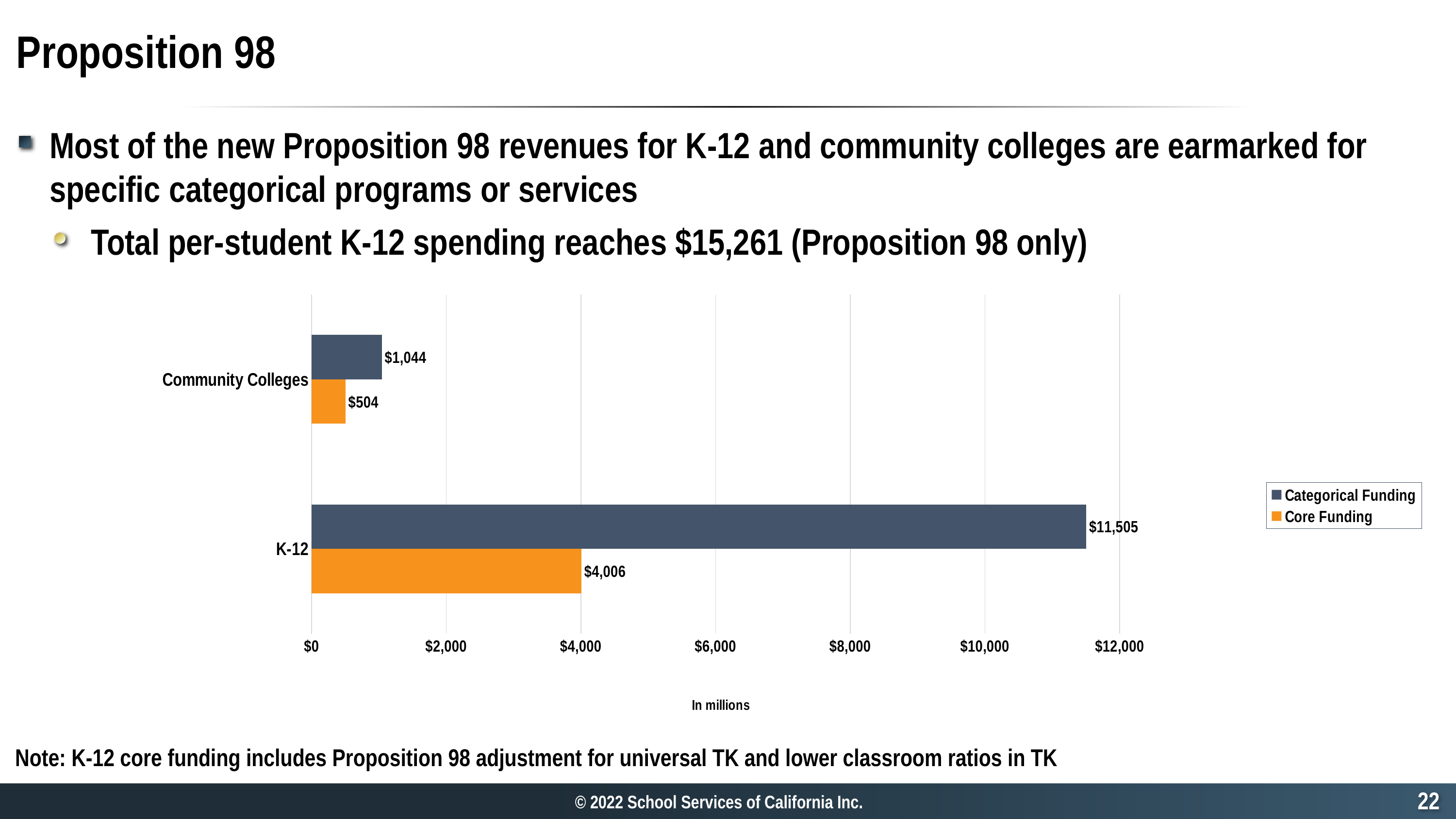
What is the difference between Categorical Funding and Core Funding for K-12? $7,499 What is the Categorical Funding value for K-12? $11,505 What kind of chart is shown on the slide? bar chart Which category has the highest Categorical Funding? K-12 Which category has the lowest Core Funding? Community Colleges What is the Core Funding value for Community Colleges? $504 How many series does the legend list? 2 Is the Categorical Funding value for K-12 greater or less than $10,000? greater What is the Core Funding value for K-12? $4,006 Which is larger for Community Colleges: Categorical Funding or Core Funding? Categorical Funding How many categories are shown on the chart? 2 What is the Categorical Funding value for Community Colleges? $1,044